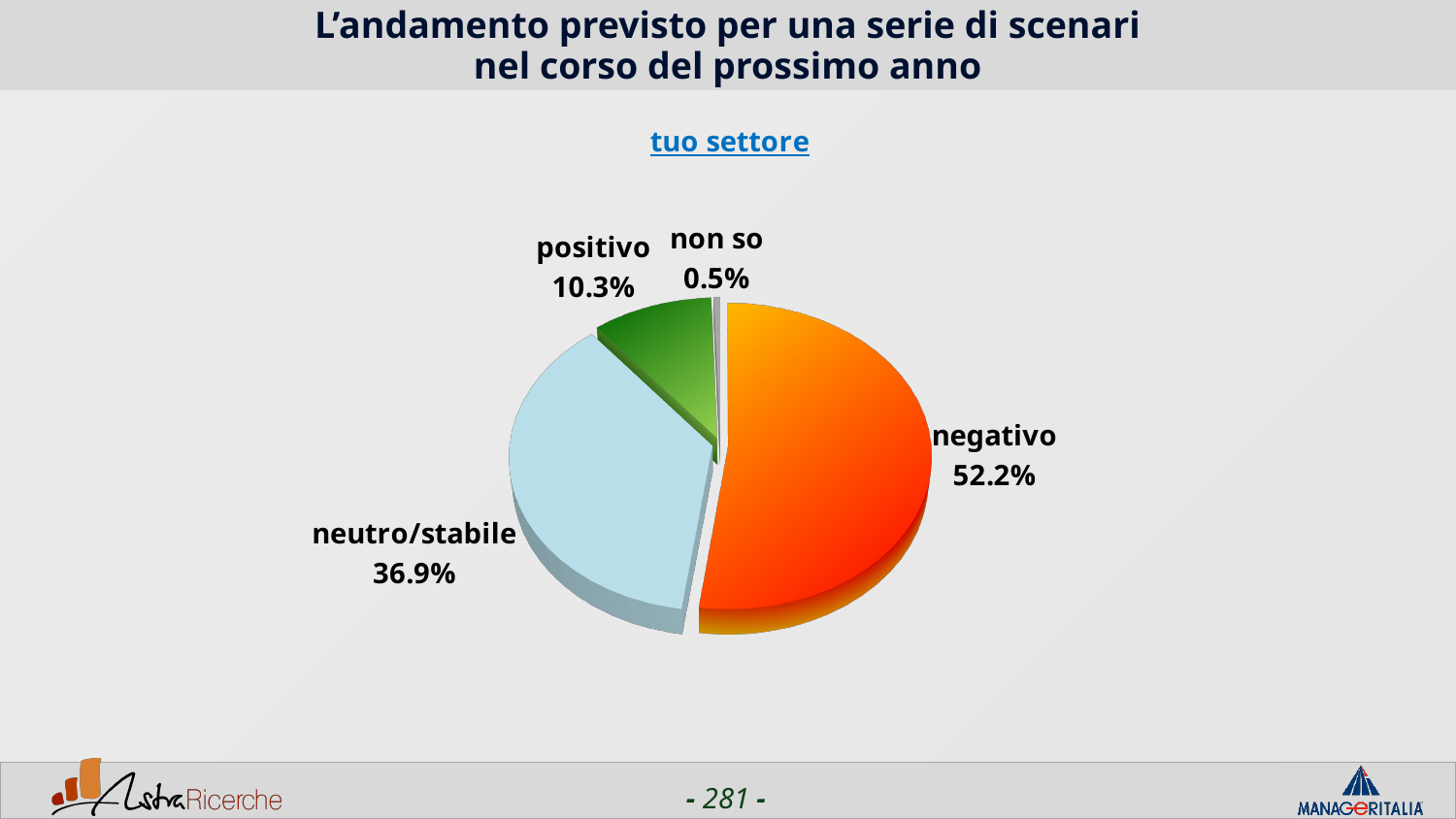
What is the difference between the values for "negativo" and "neutro/stabile"? 15.3% Which category has the smallest slice? non so Which is larger, the value for "positivo" or the value for "neutro/stabile"? neutro/stabile What is the value for "non so"? 0.5% How many categories does the pie chart show? 4 What is the subtitle shown above the pie chart? tuo settore What colour is the "positivo" slice? green What is the value for "negativo"? 52.2% What kind of chart is shown on the slide? pie chart What is the value for "positivo"? 10.3% Which category has the largest slice? negativo What is the value for "neutro/stabile"? 36.9%